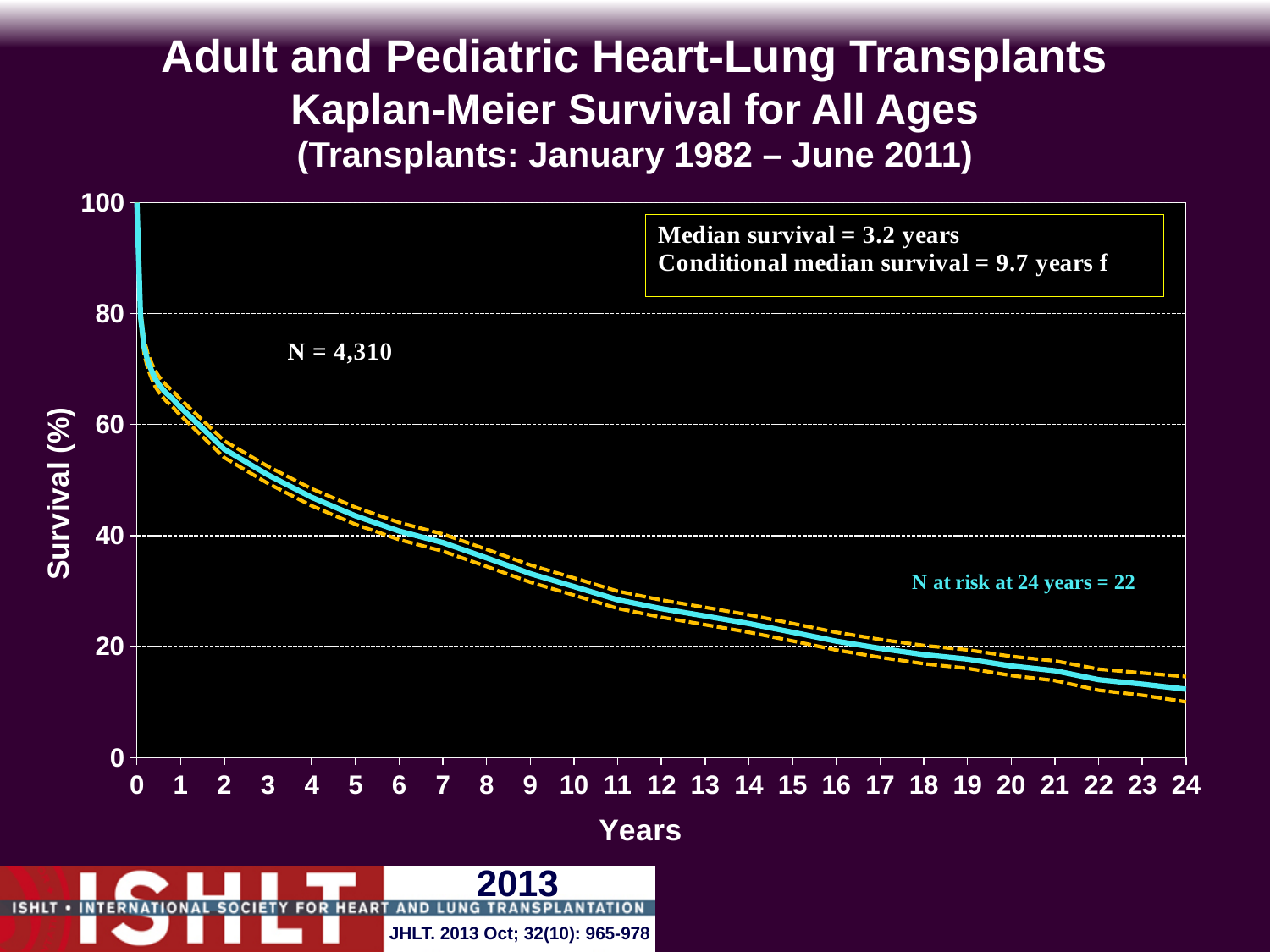
Is the survival value at 5 years greater or less than 40? greater What kind of chart is shown on the slide? line chart Is the survival value at 10 years greater or less than 40? less What is the last year shown on the x axis? 24 Does survival rise or fall as the years increase along the x axis? fall What is the value of N shown on the chart? 4,310 What is the median survival stated on the chart? 3.2 years What is the N at risk at 24 years? 22 What is the conditional median survival stated on the chart? 9.7 years What is the label of the y axis? Survival (%) Is the survival value at 20 years greater or less than 20? less